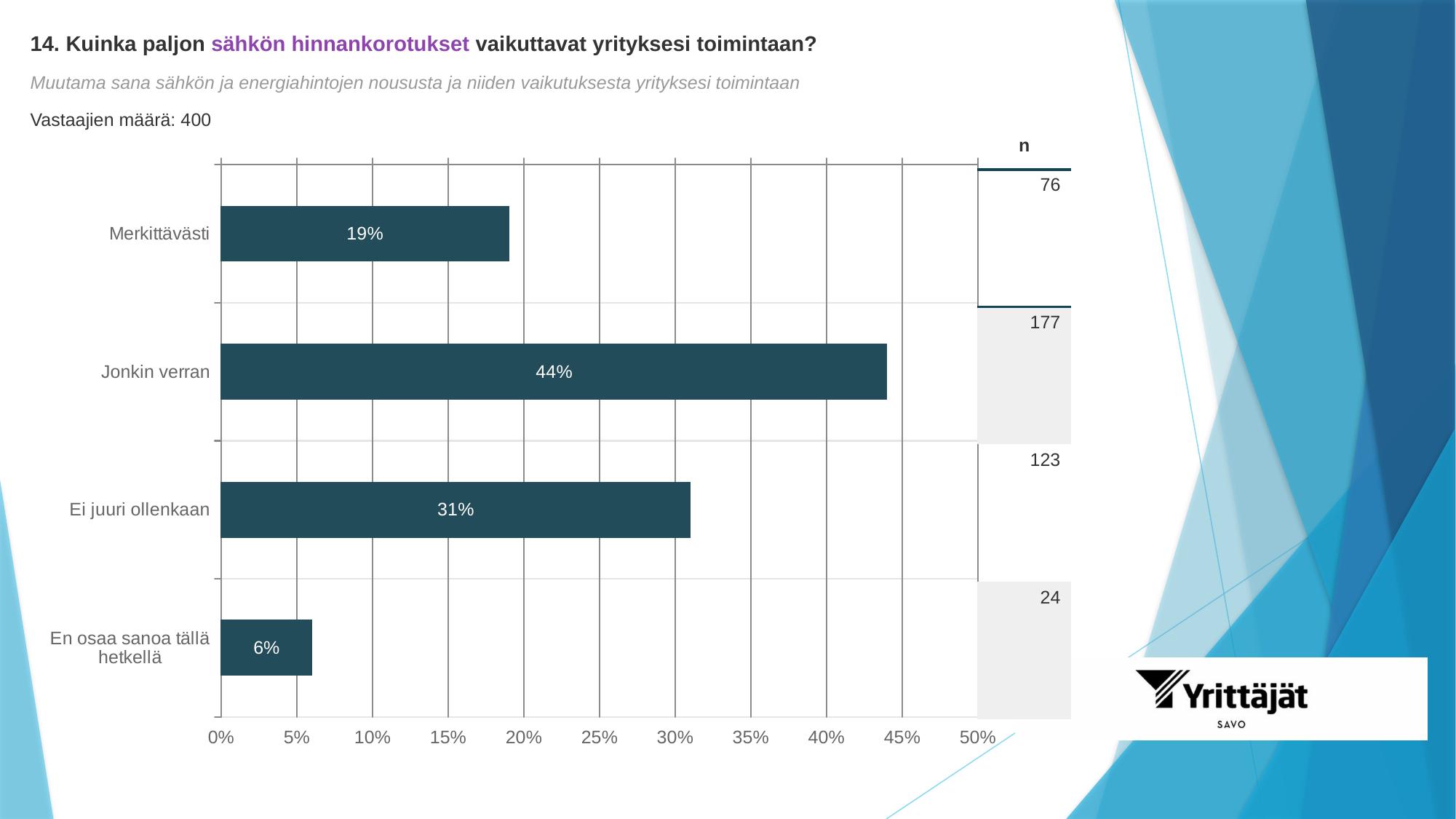
What percentage of respondents answered "Jonkin verran"? 44% What percentage of respondents answered "Merkittävästi"? 19% Which category has the highest percentage? Jonkin verran What kind of chart is shown on the slide? Bar chart What is the total number of respondents stated on the slide (Vastaajien määrä)? 400 How many categories are shown in the chart? 4 What is the n value (number of respondents) for "Ei juuri ollenkaan"? 123 Which category has the lowest percentage? En osaa sanoa tällä hetkellä What is the difference between the n values for "Jonkin verran" and "Merkittävästi"? 101 What is the n value for "En osaa sanoa tällä hetkellä"? 24 What is the difference in percentage points between "Jonkin verran" and "Ei juuri ollenkaan"? 13 percentage points Which is larger, the percentage for "Merkittävästi" or for "Ei juuri ollenkaan"? Ei juuri ollenkaan